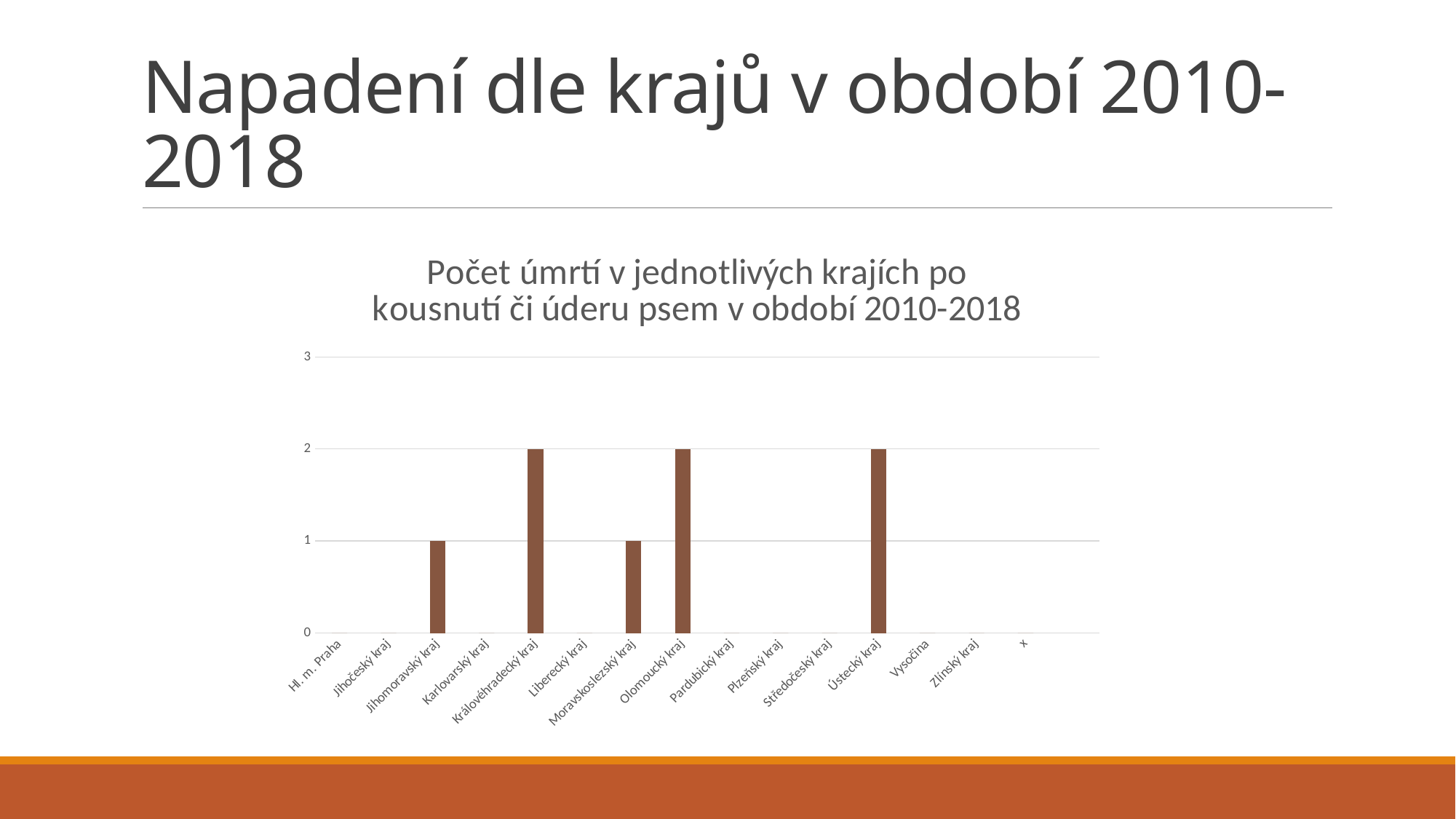
What is the value for Jihomoravský kraj? 1 What is the value for Ústecký kraj? 2 What kind of chart is shown on the slide? bar chart What colour are the bars in the chart? brown What is the value for Olomoucký kraj? 2 What is the value for Moravskoslezský kraj? 1 What is the value for Královéhradecký kraj? 2 Which is larger, the value for Olomoucký kraj or the value for Moravskoslezský kraj? Olomoucký kraj What is the title of the chart? Počet úmrtí v jednotlivých krajích po kousnutí či úderu psem v období 2010-2018 How many categories have a bar with a value greater than 0? 5 How many categories are shown on the x axis? 15 What is the difference between the value for Královéhradecký kraj and the value for Jihomoravský kraj? 1